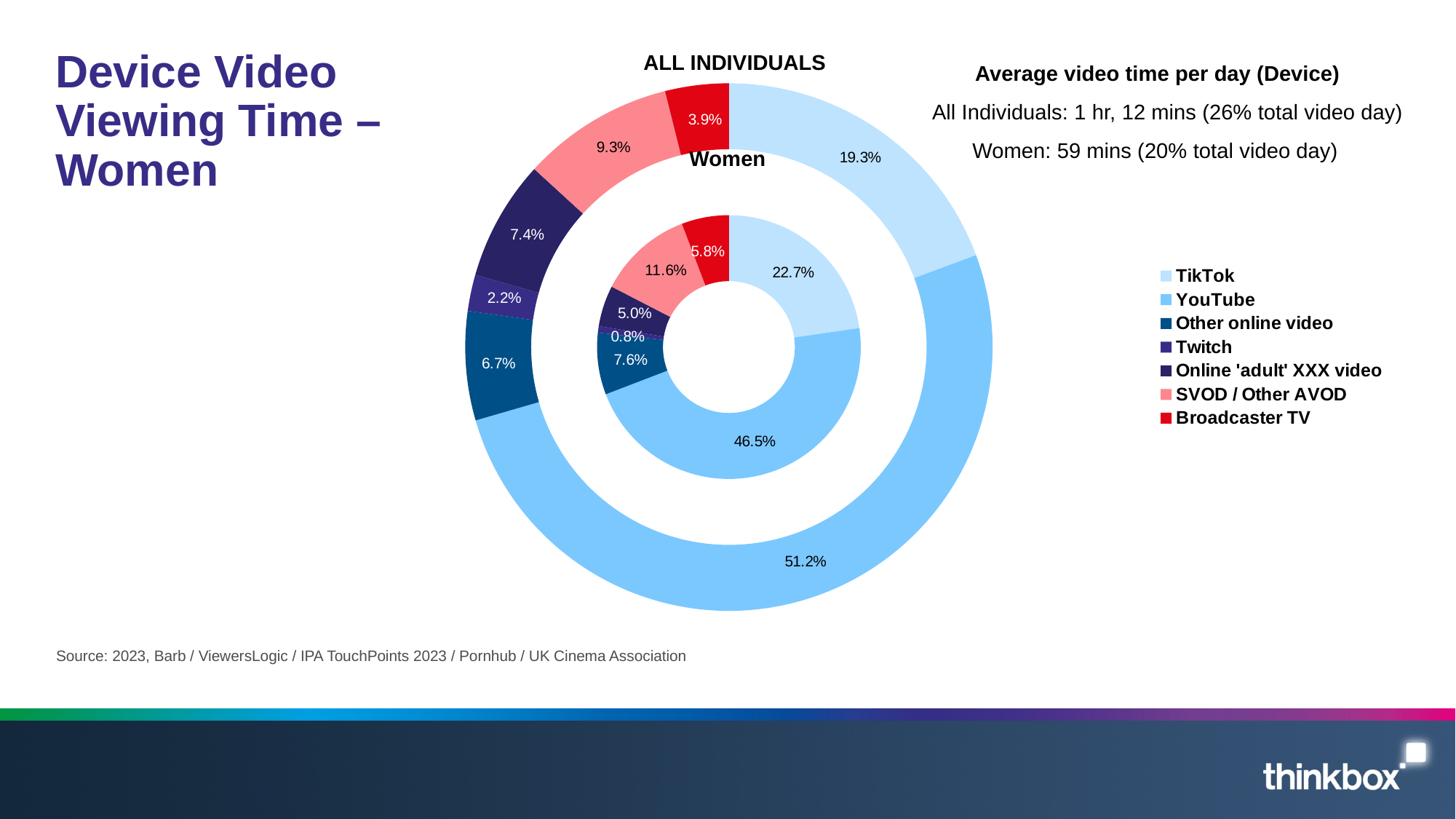
Which category has the smallest share in the All Individuals ring? Twitch How many series does the legend list? 7 Which category has the smallest share in the Women ring? Twitch What is the difference between the YouTube share for All Individuals (51.2%) and for Women (46.5%)? 4.7% Which category has the largest share in the Women ring? YouTube What kind of chart is shown on the slide? Doughnut chart In the outer ring (All Individuals), what is the share for Twitch? 2.2% Which ring of the doughnut represents Women, the inner or the outer? Inner In the inner ring (Women), what is the share for TikTok? 22.7% In the inner ring (Women), what is the share for SVOD / Other AVOD? 11.6% In the outer ring (All Individuals), what is the share for YouTube? 51.2% Is the Broadcaster TV share larger for Women or for All Individuals? Women